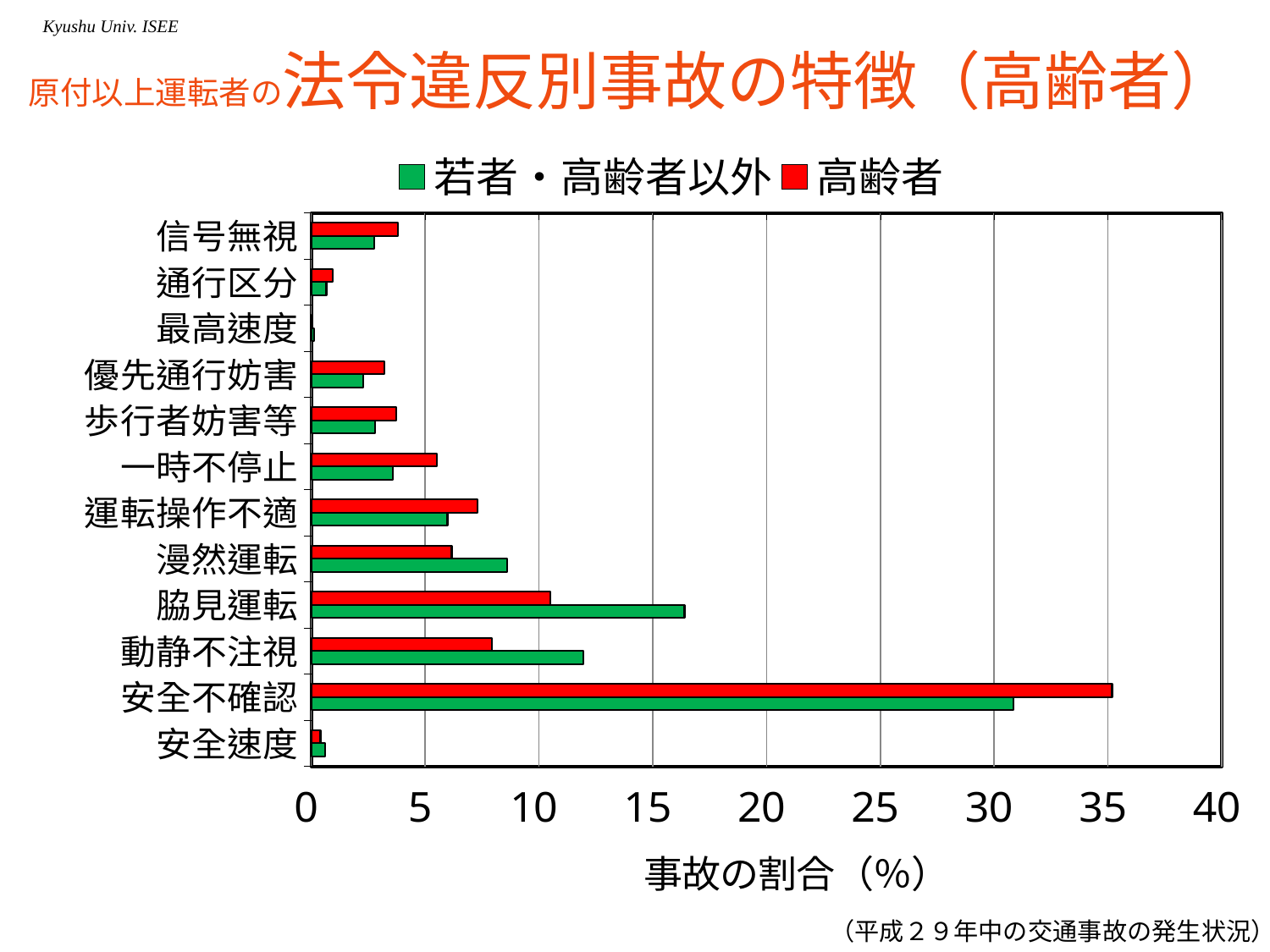
Is the value for 若者・高齢者以外 in 脇見運転 greater or less than 15? greater What is the label of the x axis? 事故の割合（%） For 脇見運転, which series has the larger value, 若者・高齢者以外 or 高齢者? 若者・高齢者以外 What kind of chart is shown on the slide? bar chart How many violation categories are plotted on the y axis? 12 Which category has the highest value for 高齢者? 安全不確認 Which category has the highest value for 若者・高齢者以外? 安全不確認 How many series does the legend list? 2 Is the value for 若者・高齢者以外 in 動静不注視 greater or less than 10? greater For 運転操作不適, which series has the larger value, 若者・高齢者以外 or 高齢者? 高齢者 Is the value for 高齢者 in 安全不確認 greater or less than 30? greater